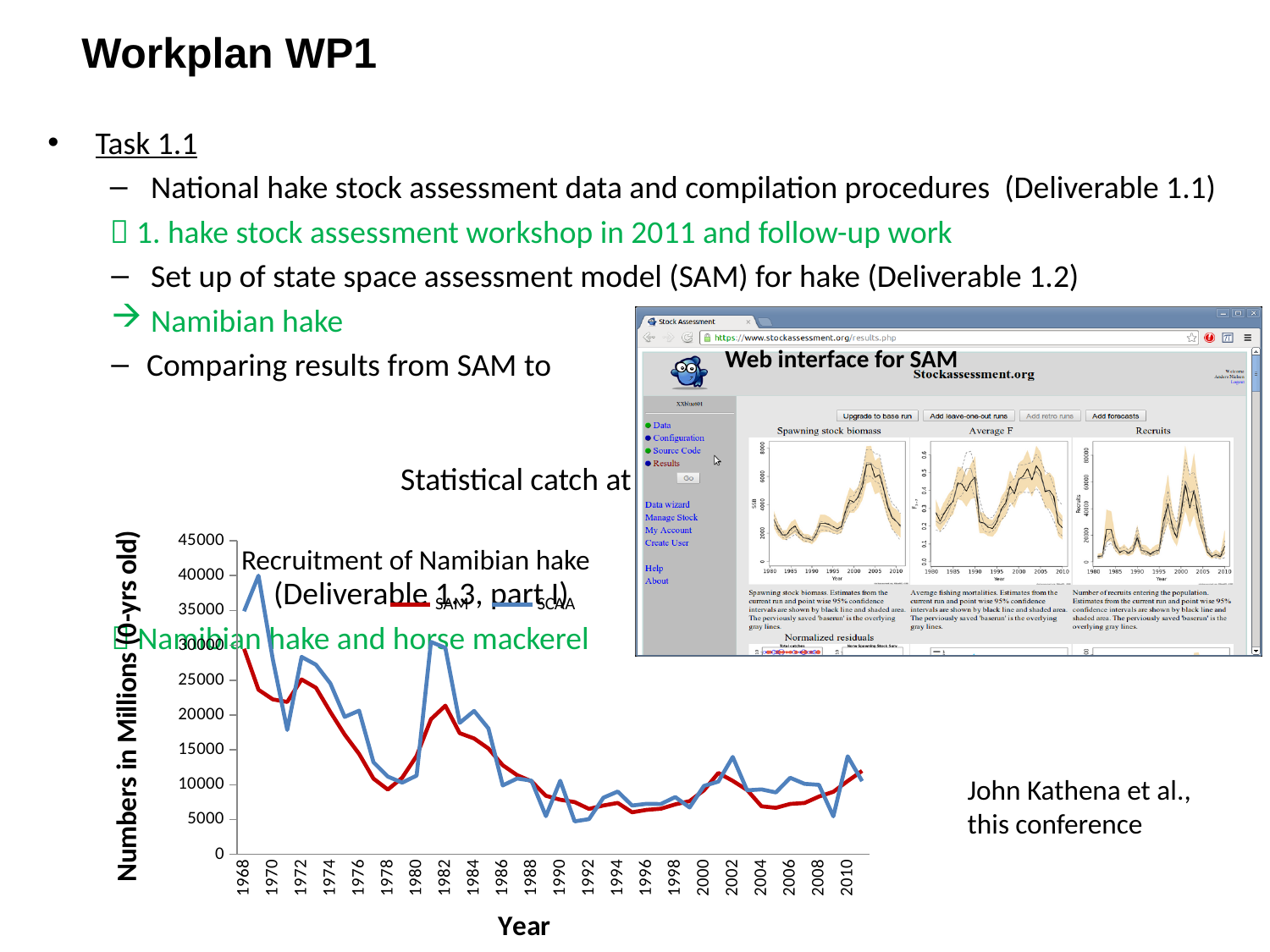
In the 'Recruitment of Namibian hake' chart, is the SCAA value for 1982 greater or less than 25000? greater In the 'Recruitment of Namibian hake' chart, is the SCAA value for 1970 greater or less than 35000? less How many series does the legend of the 'Recruitment of Namibian hake' chart list? 2 What is the y-axis title of the 'Recruitment of Namibian hake' chart? Numbers in Millions (0-yrs old) In the 'Recruitment of Namibian hake' chart, which series has the larger value in 1982, SAM or SCAA? SCAA In the 'Recruitment of Namibian hake' chart, do the recruitment values generally rise or fall from 1968 to 2010? fall In the 'Recruitment of Namibian hake' chart, is the SAM value for 1978 greater or less than 10000? less What kind of chart is the 'Recruitment of Namibian hake' chart? line chart In the 'Recruitment of Namibian hake' chart, which series has the larger value in 1970, SAM or SCAA? SCAA In the 'Recruitment of Namibian hake' chart, in which year does the SCAA series reach its highest value? 1969 What are the two series named in the legend of the 'Recruitment of Namibian hake' chart? SAM and SCAA